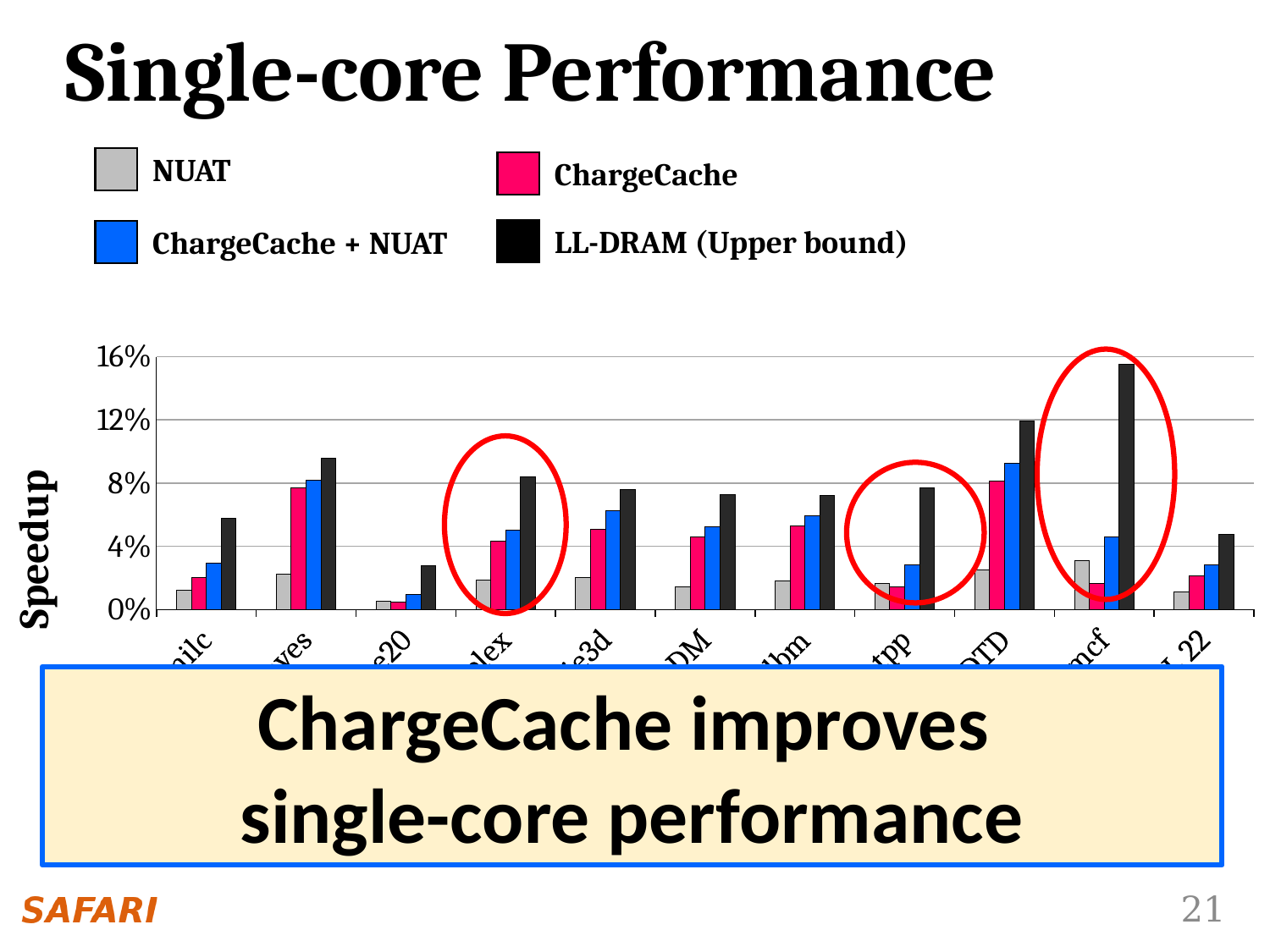
What kind of chart is shown on the slide? bar chart For mcf, which is larger: the ChargeCache bar or the ChargeCache + NUAT bar? ChargeCache + NUAT Is the NUAT value for mcf greater or less than 4%? less Which series is drawn in black? LL-DRAM (Upper bound) What is the label on the y axis? Speedup Is the LL-DRAM (Upper bound) value for mcf greater or less than 12%? greater How many series does the legend list? 4 How many benchmark categories are plotted along the x axis? 11 Is the LL-DRAM (Upper bound) value for the second category from the left greater or less than 8%? greater Which series has the tallest bar in every category? LL-DRAM (Upper bound) Which category has the tallest LL-DRAM (Upper bound) bar? mcf